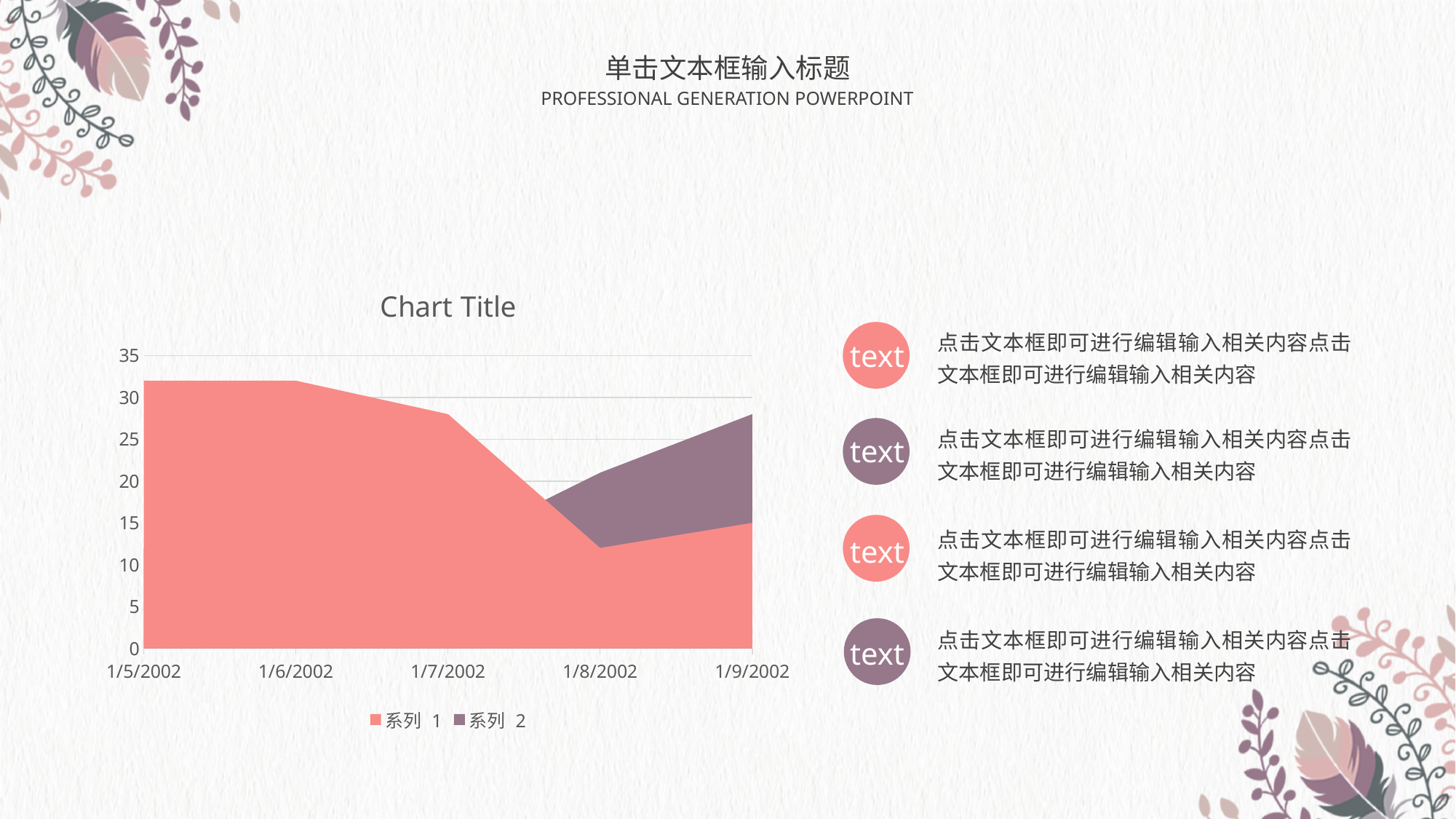
What are the two series names shown in the chart legend? 系列 1 and 系列 2 Is the value for 系列 1 at 1/7/2002 greater or less than 25? greater Is the value for 系列 1 at 1/8/2002 greater or less than 15? less Is the value for 系列 1 at 1/5/2002 greater or less than 30? greater At which date is the value for 系列 1 lowest? 1/8/2002 Does the value for 系列 1 rise or fall from 1/6/2002 to 1/8/2002? fall How many dates are shown on the x axis of the chart? 5 For 系列 1, which is larger: the value at 1/7/2002 or the value at 1/8/2002? 1/7/2002 How many series does the chart legend list? 2 What kind of chart is shown on the slide? Area chart What is the title of the chart? Chart Title